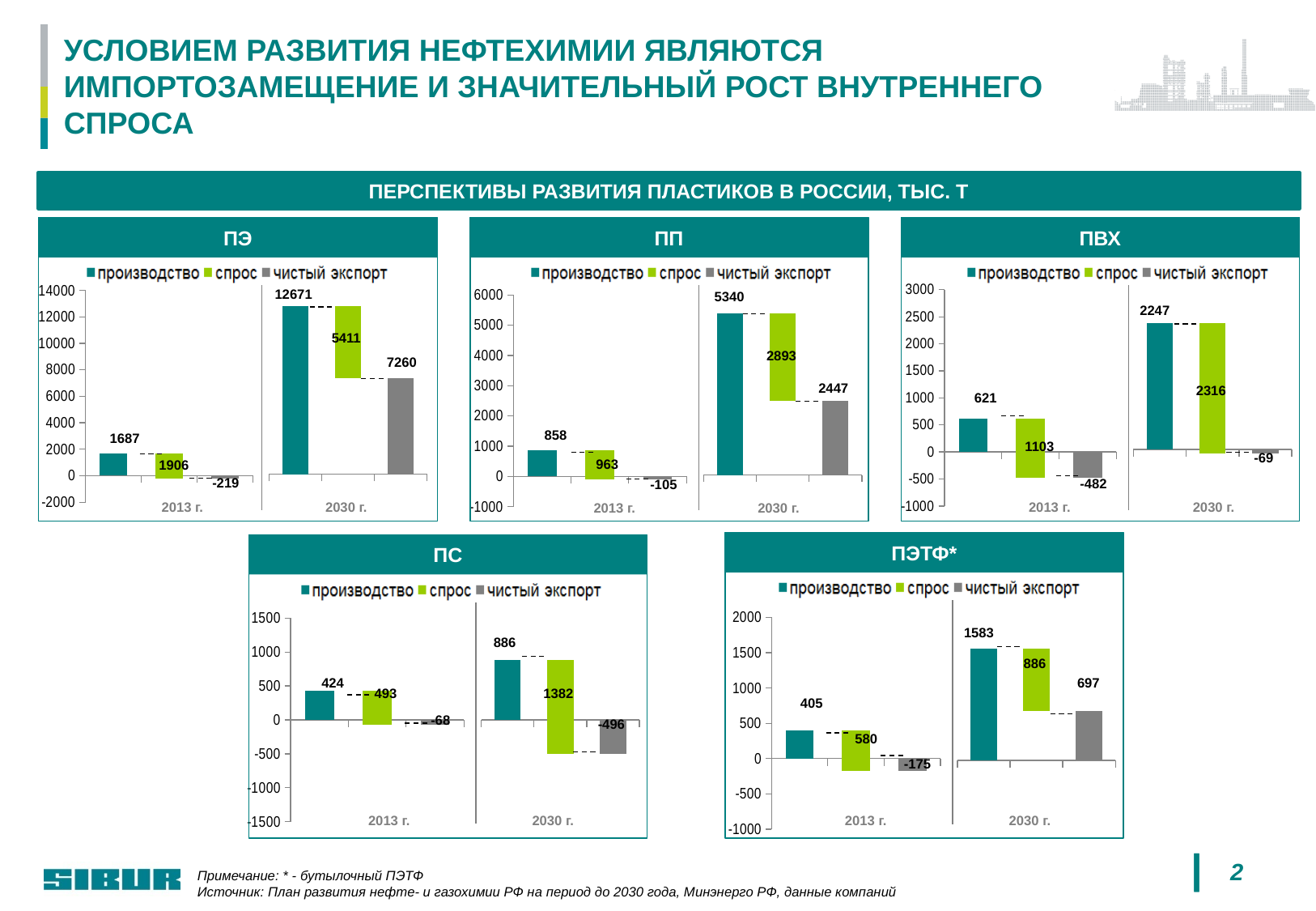
How many series does the legend of the ПС chart list? 3 In the ПЭ chart, what is the value of производство for 2030 г.? 12671 In the ПВХ chart, what is the value of спрос for 2030 г.? 2316 In the ПС chart, what is the value of чистый экспорт for 2030 г.? -496 What is the title of the band above the five charts? ПЕРСПЕКТИВЫ РАЗВИТИЯ ПЛАСТИКОВ В РОССИИ, ТЫС. Т In the ПВХ chart, is the value of производство for 2013 г. greater or less than 1000? less In the ПП chart, which is larger for 2030 г., производство or спрос? производство In the ПЭ chart, what is the difference between производство and спрос for 2030 г.? 7260 In the ПЭТФ* chart, what is the value of производство for 2013 г.? 405 In the ПП chart, what is the value of чистый экспорт for 2013 г.? -105 In the ПЭТФ* chart, does производство rise or fall from 2013 г. to 2030 г.? rise What kind of chart is the ПЭТФ* chart? bar chart